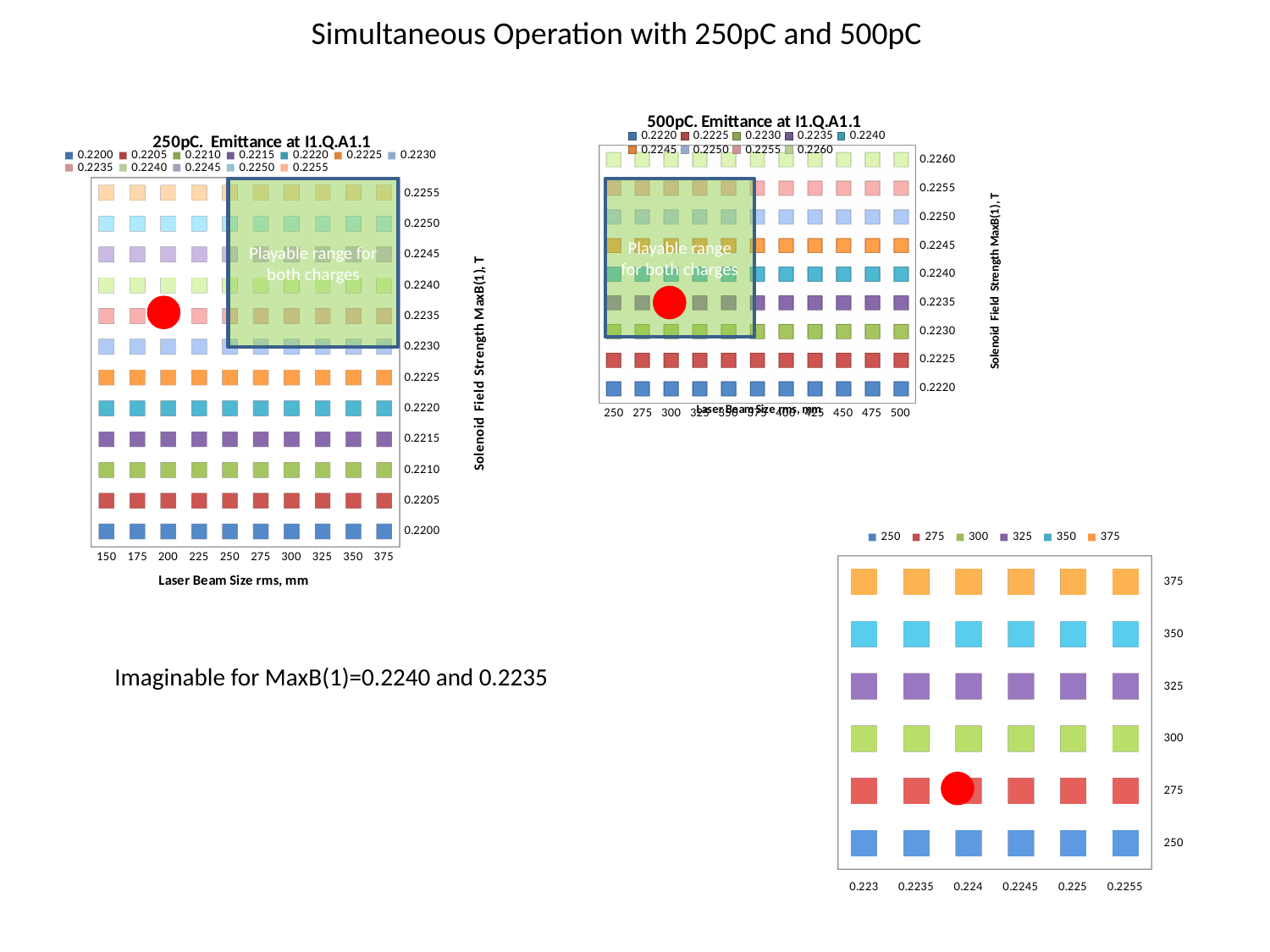
In the chart titled "250pC. Emittance at I1.Q.A1.1", how many series does the legend list? 12 In the chart titled "500pC. Emittance at I1.Q.A1.1", how many values are shown along the x axis? 11 What kind of chart is the one titled "250pC. Emittance at I1.Q.A1.1"? Scatter chart In the chart titled "250pC. Emittance at I1.Q.A1.1", what is the lowest value shown on the x axis? 150 In the untitled chart at the bottom right of the slide, what is the highest value shown on the y axis? 375 In the untitled chart at the bottom right of the slide, how many series does the legend list? 6 In the untitled chart at the bottom right of the slide, how many values are shown along the x axis? 6 What is the y-axis title of the chart titled "500pC. Emittance at I1.Q.A1.1"? Solenoid Field Strength MaxB(1), T What is the x-axis title of the chart titled "250pC. Emittance at I1.Q.A1.1"? Laser Beam Size rms, mm In the chart titled "250pC. Emittance at I1.Q.A1.1", how many values are shown along the x axis? 10 In the chart titled "500pC. Emittance at I1.Q.A1.1", what is the highest value shown on the x axis? 500 In the chart titled "500pC. Emittance at I1.Q.A1.1", how many series does the legend list? 9